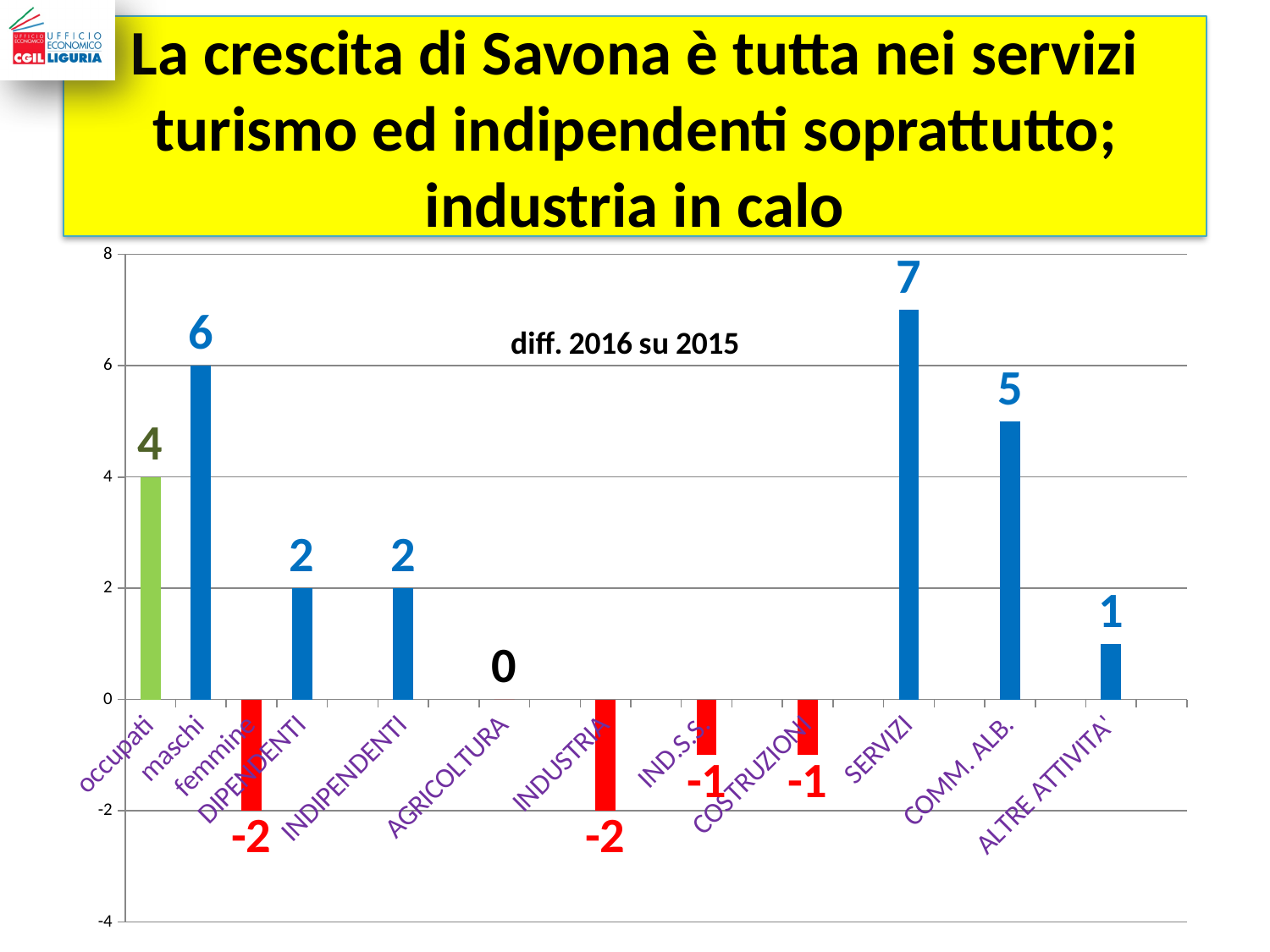
What is the value for AGRICOLTURA? 0 What is the difference between the values for SERVIZI and COMM. ALB.? 2 What is the value for COMM. ALB.? 5 What is the value for occupati? 4 How many categories are shown on the x axis? 12 What is the difference between the values for maschi and femmine? 8 What is the title printed inside the chart area? diff. 2016 su 2015 What is the value for SERVIZI? 7 What kind of chart is shown on the slide? Bar chart Which is larger, the value for INDUSTRIA or the value for COSTRUZIONI? COSTRUZIONI What is the value for femmine? -2 Which category has the highest value? SERVIZI